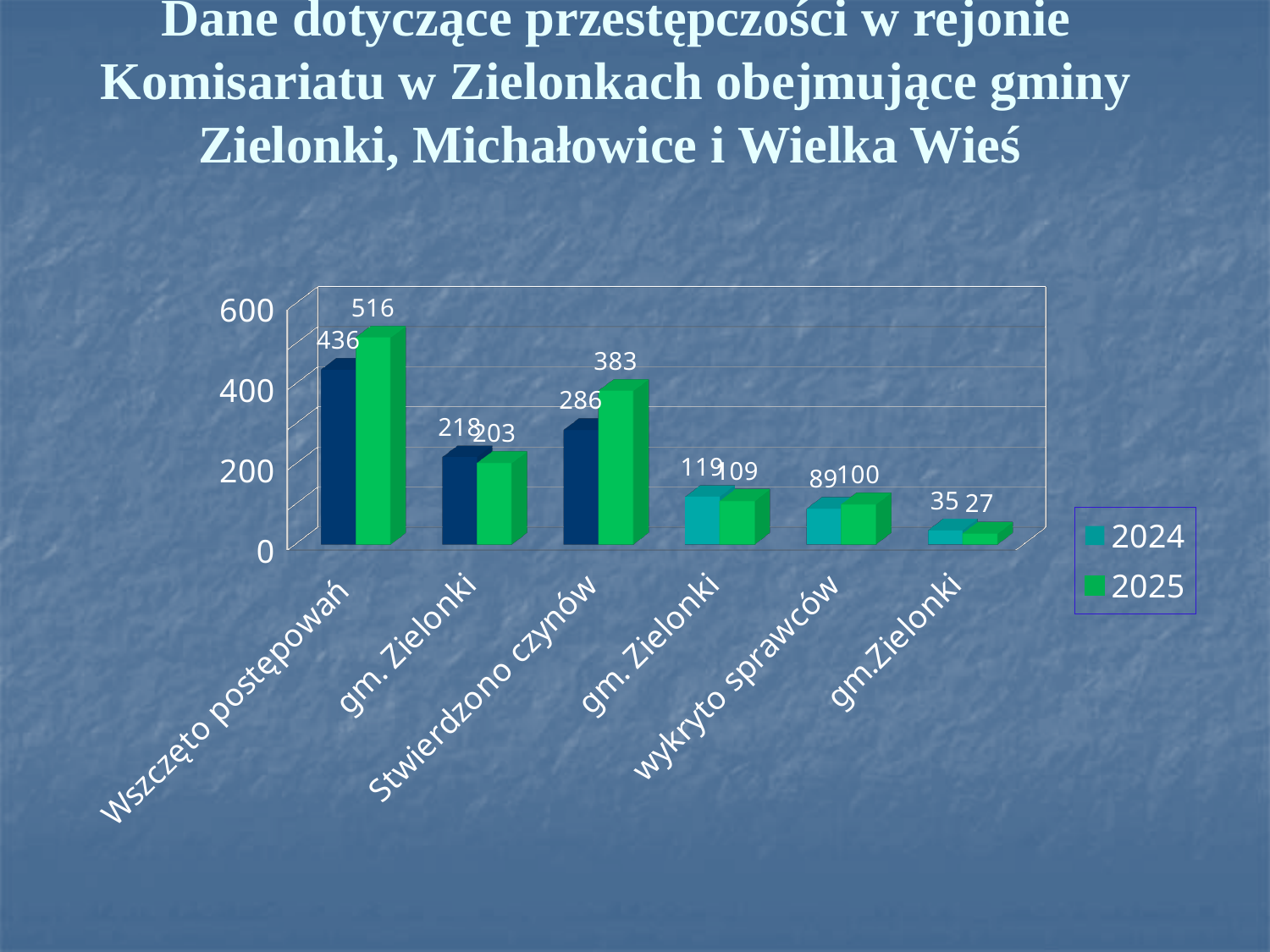
Which years are listed in the legend? 2024 and 2025 Which category has the highest 2025 value? Wszczęto postępowań What is the difference between the 2025 and 2024 values for Stwierdzono czynów? 97 Which is larger for wykryto sprawców, the 2024 value or the 2025 value? 2025 What kind of chart is shown on the slide? bar chart Is the 2024 value for Wszczęto postępowań greater or less than 400? greater What is the 2024 value for wykryto sprawców? 89 What is the 2025 value for Stwierdzono czynów? 383 What is the 2025 value for Wszczęto postępowań? 516 What is the 2024 value for Wszczęto postępowań? 436 How many categories are shown on the x axis? 6 How many series does the legend list? 2